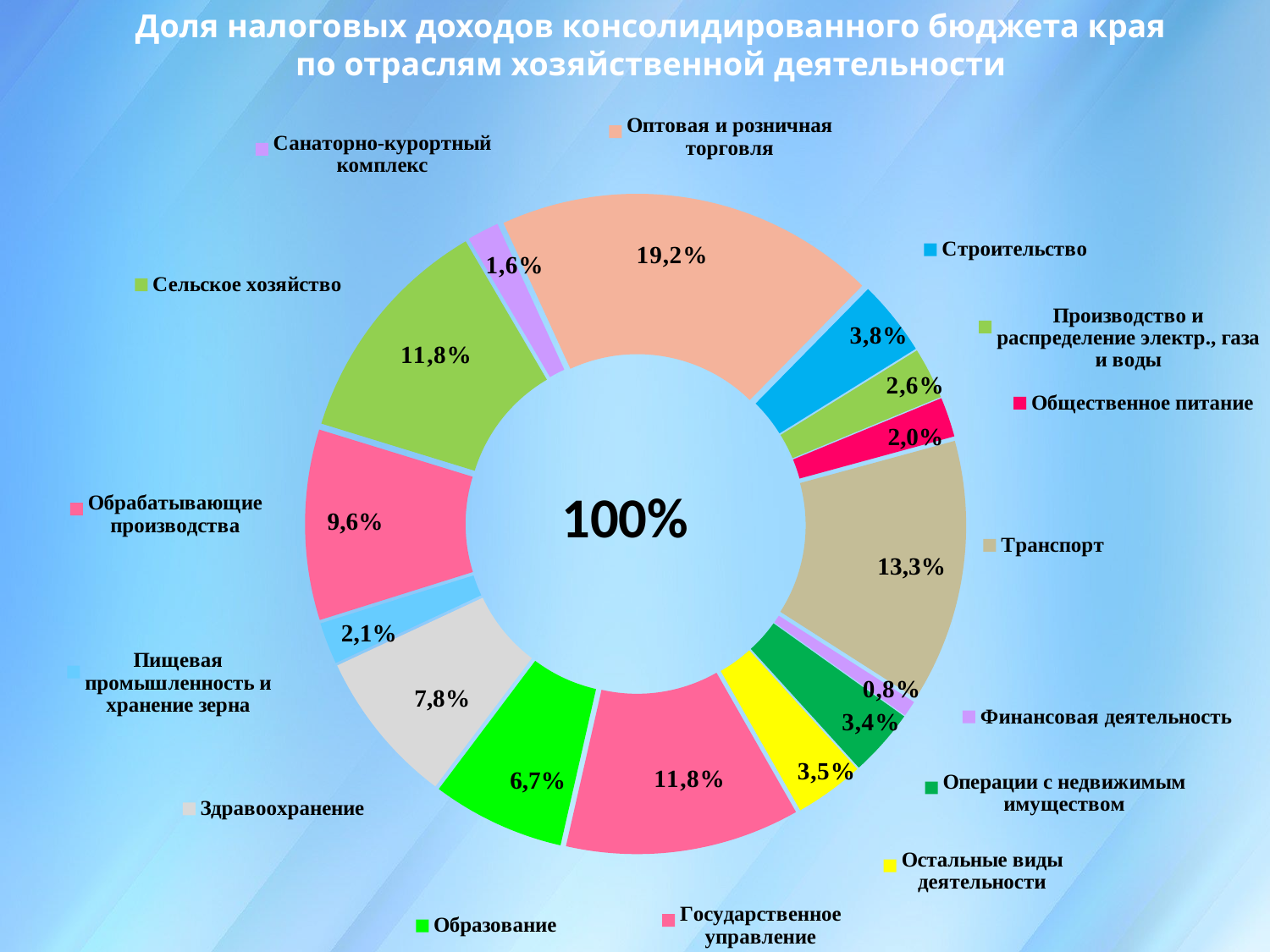
Какая доля приходится на «Операции с недвижимым имуществом»? 3,4% Какой тип диаграммы показан на слайде? Кольцевая (круговая) диаграмма Что больше: доля «Строительство» или доля «Общественное питание»? Строительство Какая отрасль имеет наименьшую долю налоговых доходов? Финансовая деятельность Сколько отраслей (категорий) показано на диаграмме? 15 Какая доля приходится на «Транспорт»? 13,3% Какая доля приходится на «Здравоохранение»? 7,8% Какая доля приходится на «Оптовая и розничная торговля»? 19,2% Что больше: доля «Обрабатывающие производства» или доля «Здравоохранение»? Обрабатывающие производства На сколько процентных пунктов доля «Оптовая и розничная торговля» больше доли «Транспорт»? 5,9 Какая отрасль имеет наибольшую долю налоговых доходов? Оптовая и розничная торговля Какое значение указано в центре диаграммы? 100%